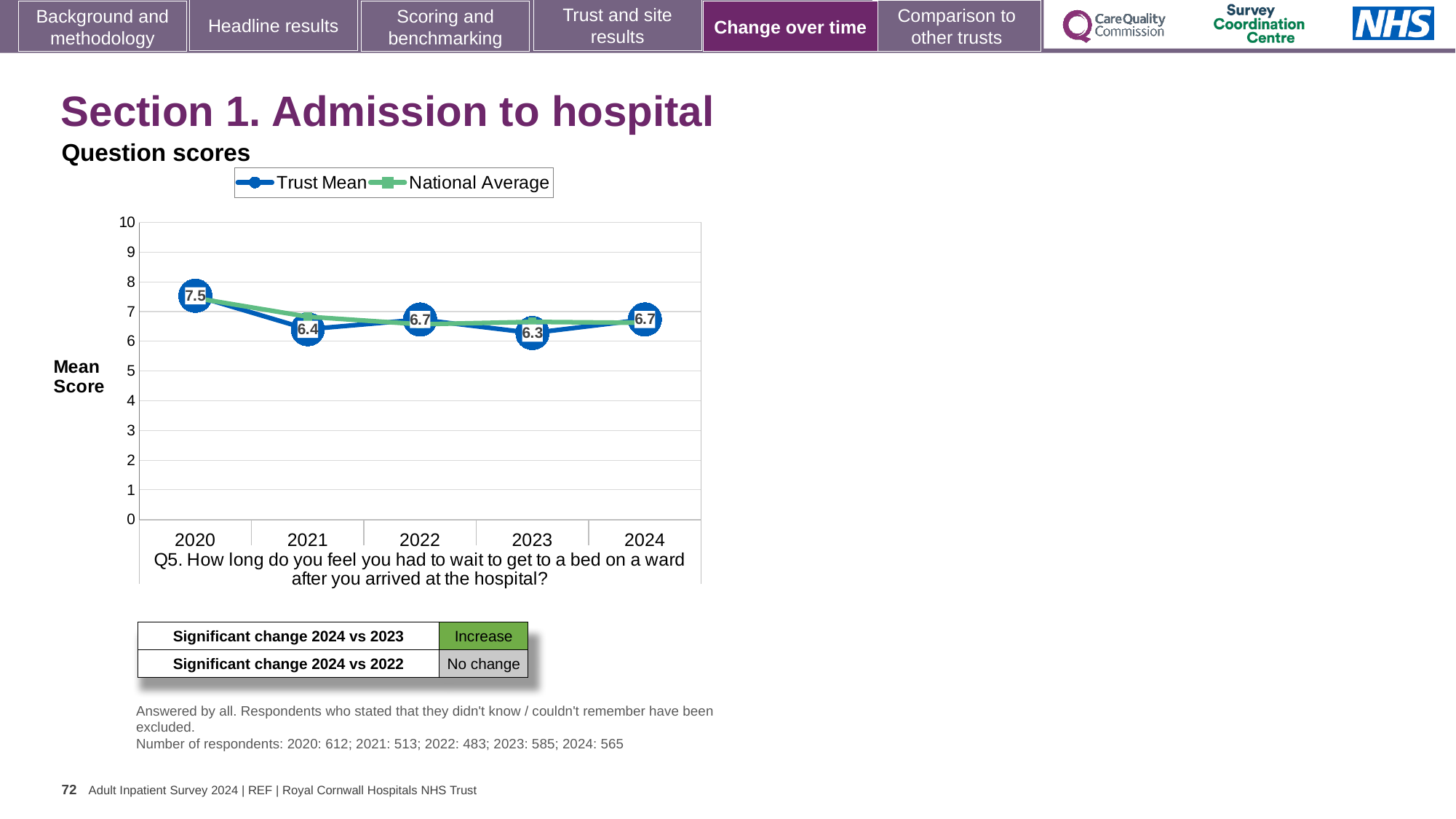
In which year is the Trust Mean score lowest? 2023 What is the Trust Mean score for 2024? 6.7 How many years are plotted on the x axis? 5 Does the Trust Mean score rise or fall from 2020 to 2021? Fall What is the Trust Mean score for 2020? 7.5 How many series does the legend list? 2 Is the National Average value for 2020 greater or less than 7? greater What is the difference between the Trust Mean score in 2020 and in 2021? 1.1 Which year has the larger Trust Mean score, 2021 or 2023? 2021 What is the Trust Mean score for 2023? 6.3 What kind of chart is shown on the slide? Line chart In which year is the Trust Mean score highest? 2020